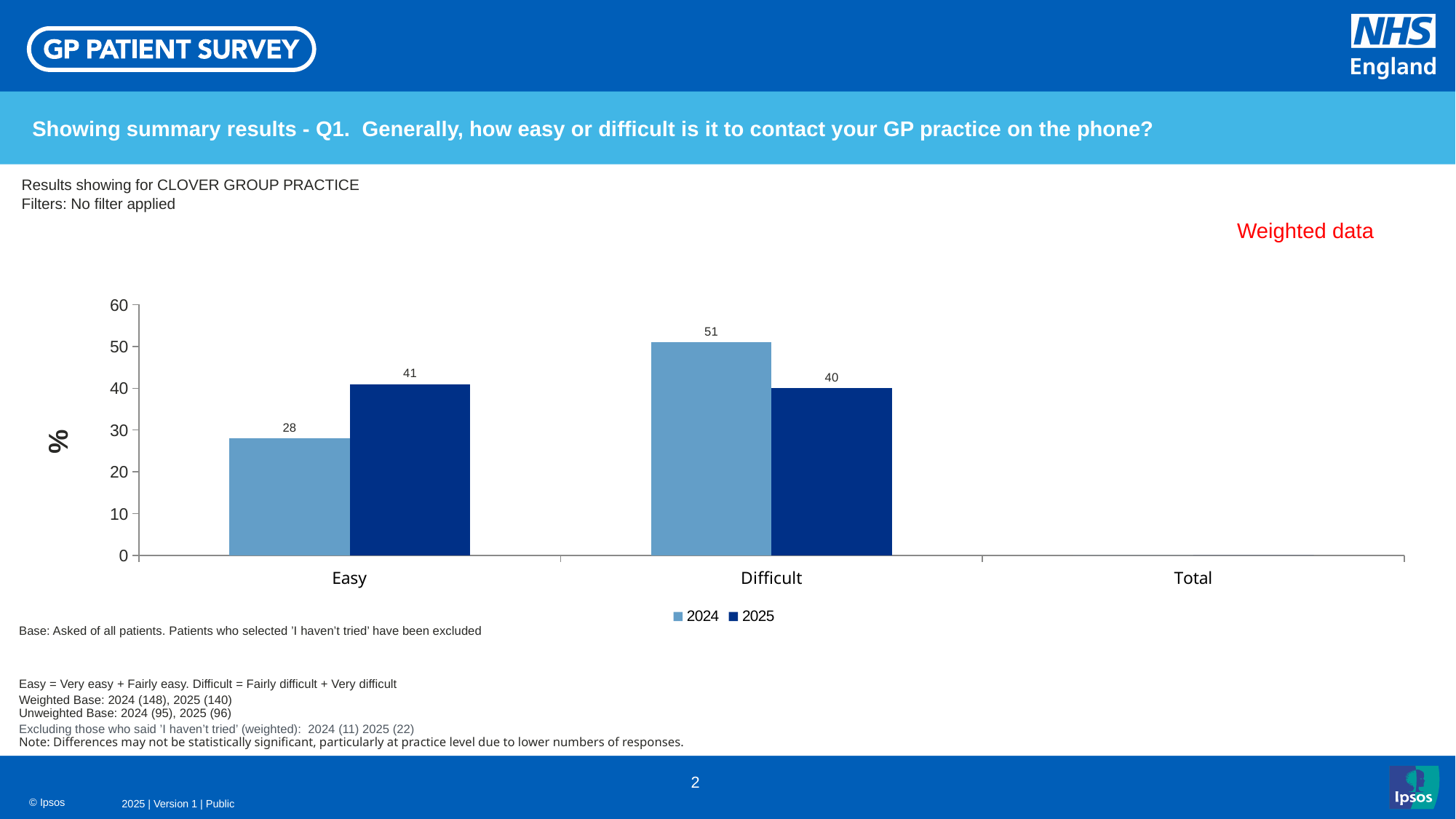
Which is larger for Easy: the 2024 value or the 2025 value? 2025 Which category has the lowest value in the 2024 series? Easy What is the difference between the 2025 and 2024 values for Easy? 13 What is the difference between the 2024 and 2025 values for Difficult? 11 What is the value for Easy in 2024? 28 What is the value for Easy in 2025? 41 What is the value for Difficult in 2025? 40 What kind of chart is shown on the slide? Bar chart Which category has the highest value in the 2024 series? Difficult How many series does the legend list? 2 What is the value for Difficult in 2024? 51 What label is shown on the vertical axis of the chart? %